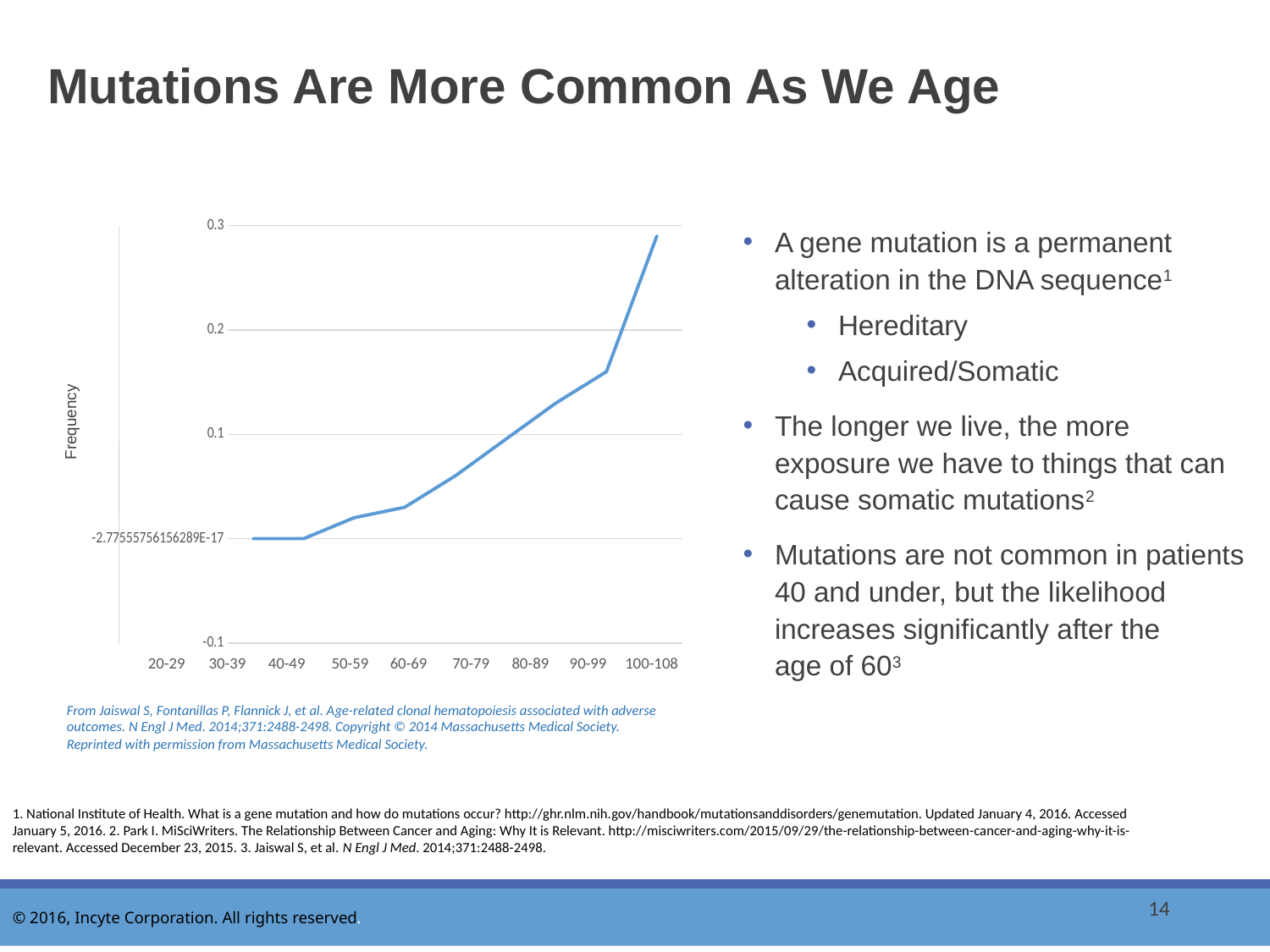
Does the frequency rise or fall as age increases along the x axis? rises How many age-group categories are shown on the x axis of the chart? 9 Is the frequency for the 100-108 age group greater or less than 0.2? greater Is the frequency for the 60-69 age group greater or less than 0.1? less Which age group has the highest frequency in the chart? 100-108 Which has the higher frequency, the 90-99 age group or the 40-49 age group? 90-99 What kind of chart is shown on the slide? line chart Which has the higher frequency, the 100-108 age group or the 50-59 age group? 100-108 Is the frequency for the 90-99 age group greater or less than 0.1? greater What is the label of the y axis of the chart? Frequency